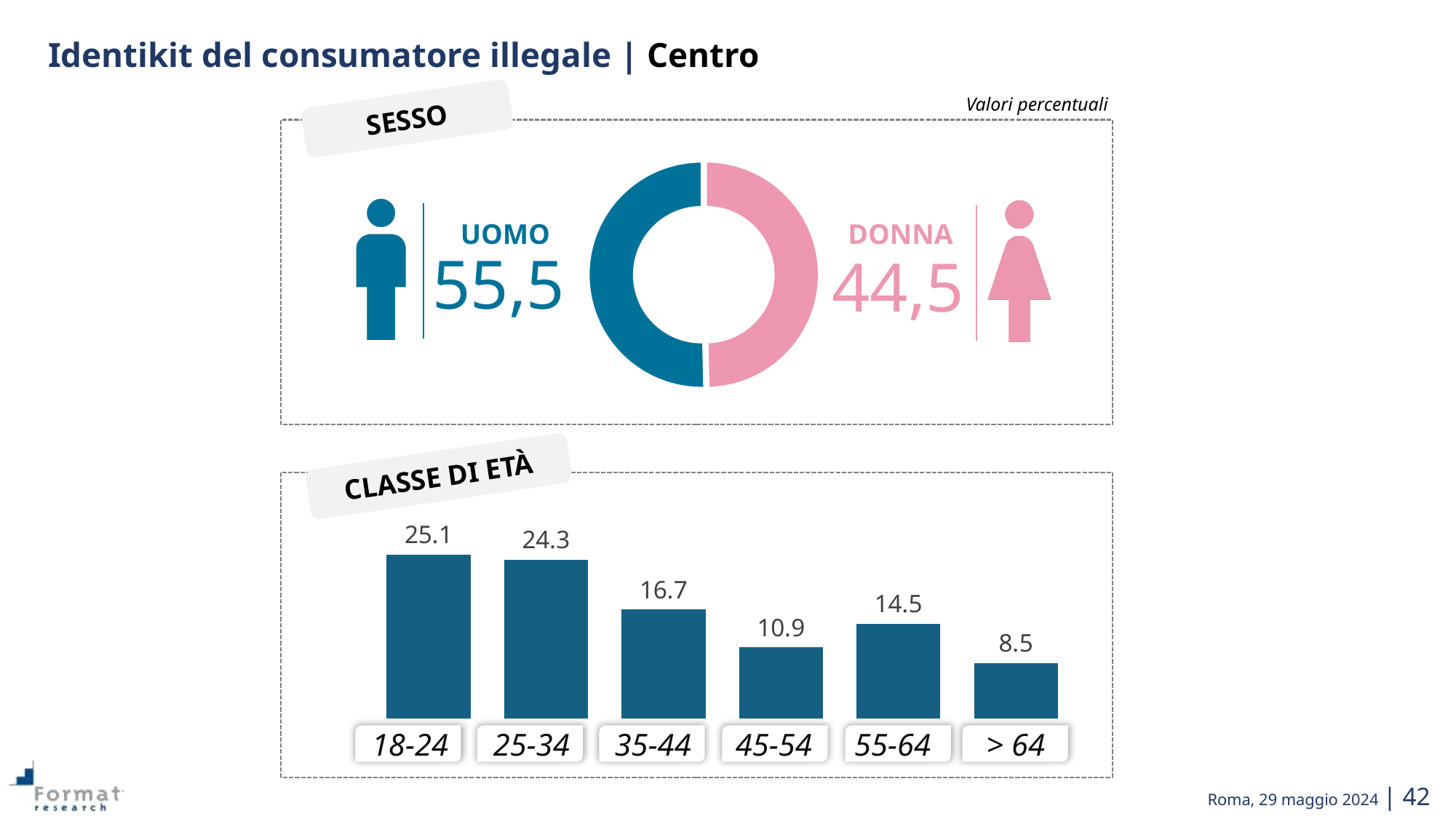
In the CLASSE DI ETÀ chart, which age class has the highest value? 18-24 What kind of chart is the CLASSE DI ETÀ chart? Bar chart In the CLASSE DI ETÀ chart, what is the difference between the values for 18-24 and 45-54? 14.2 How many age classes are shown in the CLASSE DI ETÀ chart? 6 In the SESSO chart, what is the value for UOMO? 55,5 In the SESSO chart, what is the value for DONNA? 44,5 In the CLASSE DI ETÀ chart, what is the value for > 64? 8.5 In the CLASSE DI ETÀ chart, which age class has the lowest value? > 64 In the SESSO chart, which category is larger, UOMO or DONNA? UOMO In the CLASSE DI ETÀ chart, what is the value for 35-44? 16.7 What kind of chart is the SESSO chart? Doughnut chart In the SESSO chart, what is the difference between the UOMO and DONNA values? 11